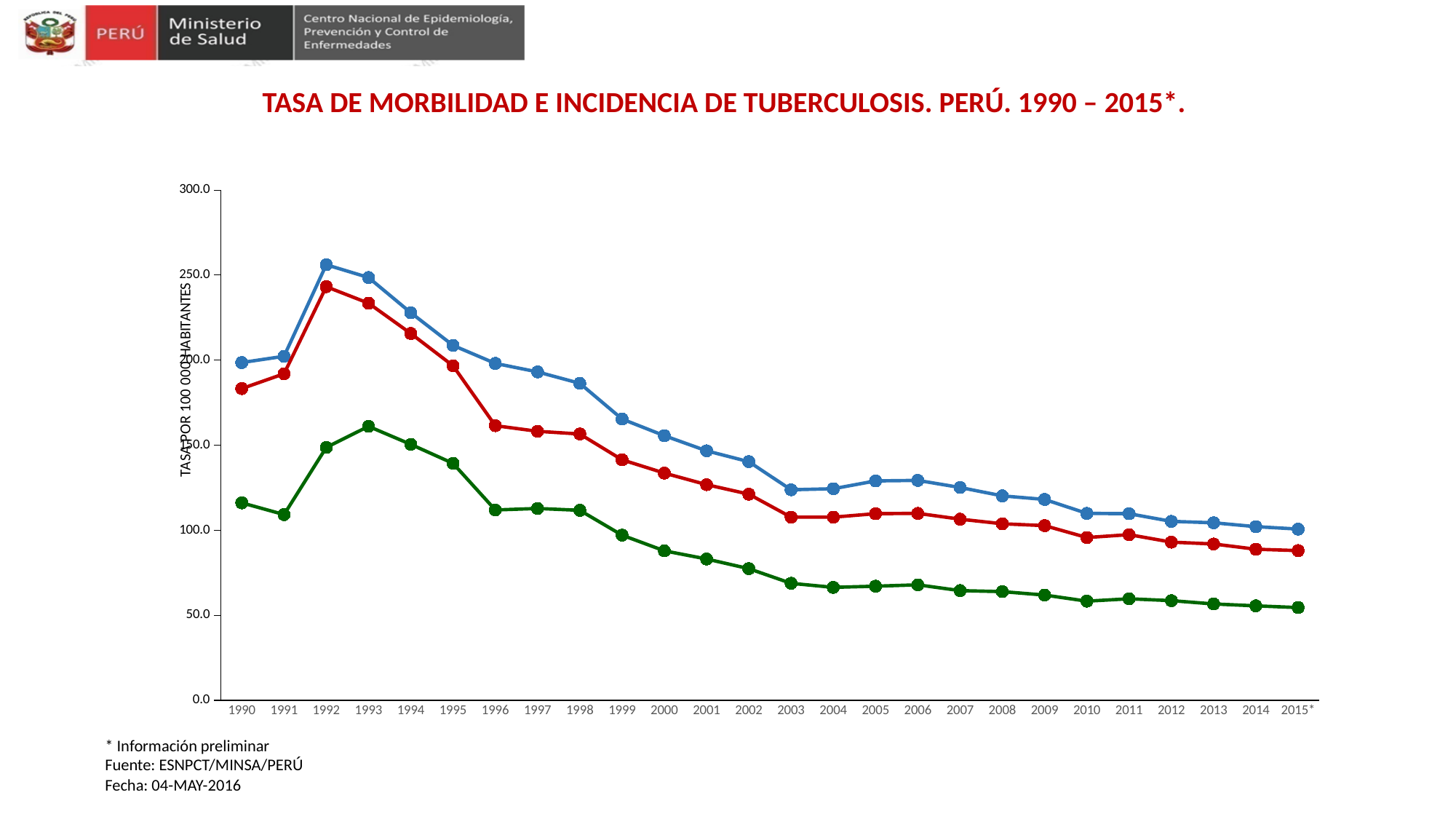
In which year does the blue line reach its highest value? 1992 How many lines are plotted on the chart? 3 Is the value of the blue line in 2003 greater or less than 100? greater In 2000, which line has the larger value, the red line or the green line? Red line Overall, do the values of the blue line rise or fall from 1992 to 2015*? Fall Is the value of the green line in 1993 greater or less than 150? greater What kind of chart is shown on the slide? Line chart Is the value of the red line in 1992 greater or less than 250? less How many years are plotted along the x axis of the chart? 26 In which year does the green line reach its highest value? 1993 What is the title of the chart? TASA DE MORBILIDAD E INCIDENCIA DE TUBERCULOSIS. PERÚ. 1990 – 2015*.